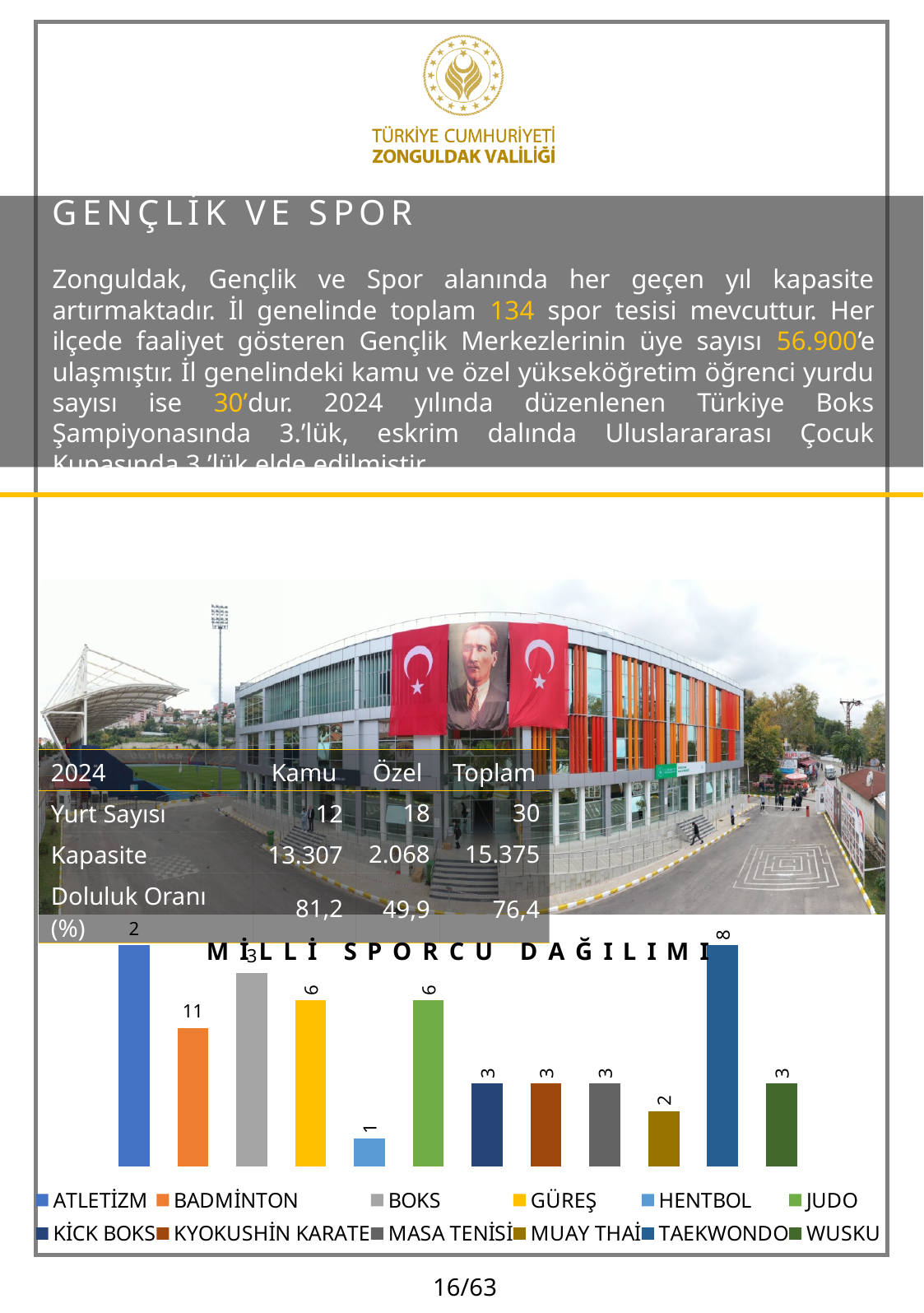
What kind of chart is the MİLLİ SPORCU DAĞILIMI chart? bar chart How many categories are shown in the MİLLİ SPORCU DAĞILIMI chart? 12 In the MİLLİ SPORCU DAĞILIMI chart, which category has the highest bar? ATLETİZM and TAEKWONDO (tied at 8) In the MİLLİ SPORCU DAĞILIMI chart, which category has the lowest value? HENTBOL In the MİLLİ SPORCU DAĞILIMI chart, what is the value for TAEKWONDO? 8 In the MİLLİ SPORCU DAĞILIMI chart, which is larger, JUDO or MUAY THAİ? JUDO What is the title of the chart at the bottom of the slide? MİLLİ SPORCU DAĞILIMI In the MİLLİ SPORCU DAĞILIMI chart, what is the value for HENTBOL? 1 In the MİLLİ SPORCU DAĞILIMI chart, what is the value for MUAY THAİ? 2 In the MİLLİ SPORCU DAĞILIMI chart, what is the value for GÜREŞ? 6